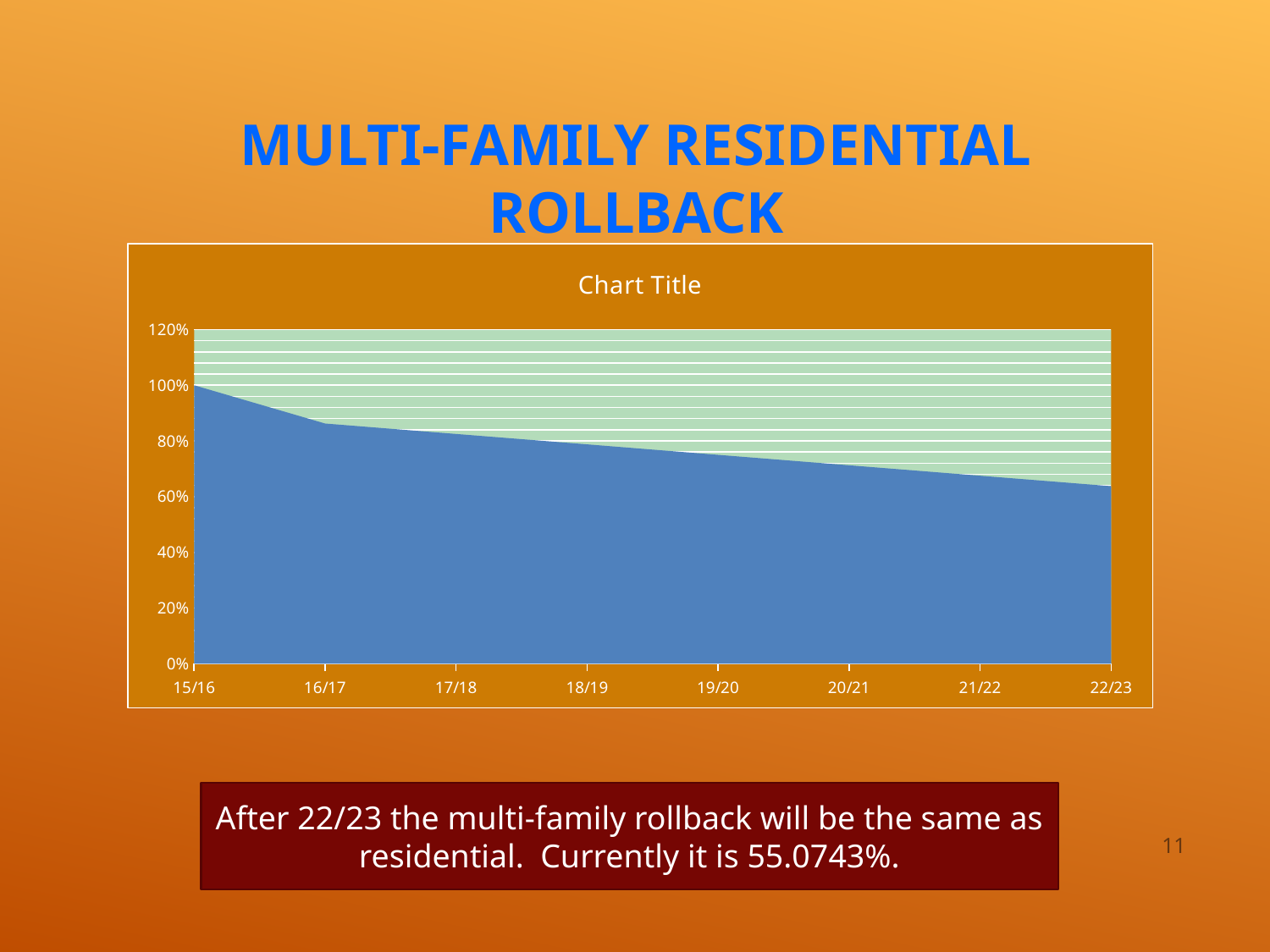
Which year has the highest value? 15/16 Is the value for 20/21 greater or less than 80%? less What kind of chart is shown on the slide? Area chart Is the value for 22/23 greater or less than 80%? less What title is printed above the chart? Chart Title Do the values rise or fall from 15/16 to 22/23? Fall Which is larger, the value for 16/17 or the value for 22/23? 16/17 What is the value for 15/16? 100% Which year has the lowest value? 22/23 How many fiscal-year categories are shown on the x axis? 8 Is the value for 16/17 greater or less than 80%? greater